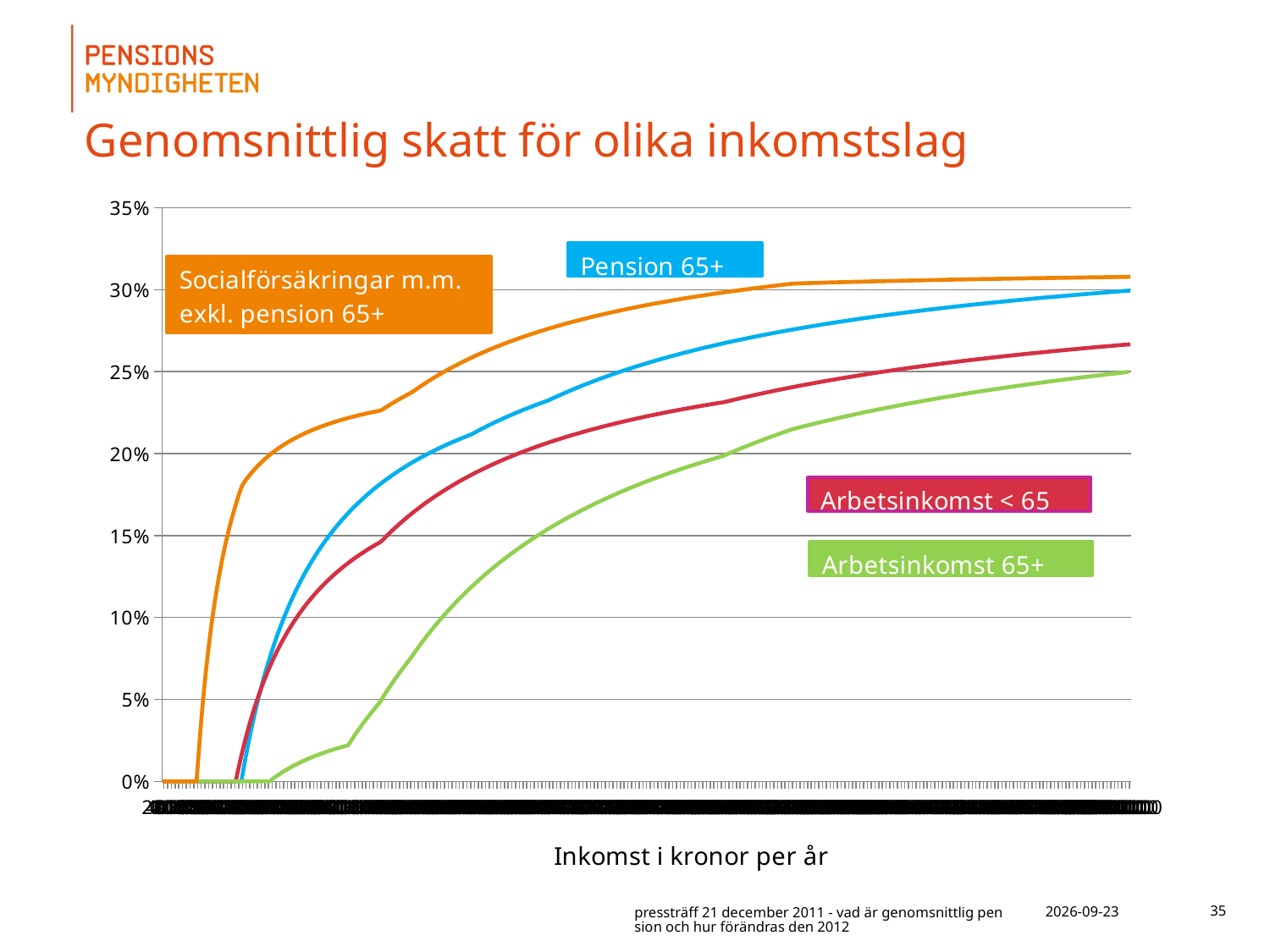
Is the highest value reached by the Arbetsinkomst 65+ line greater or less than 30%? less Do the values of the lines rise or fall as income increases along the x axis? Rise At the right end of the chart, which is larger: Pension 65+ or Arbetsinkomst < 65? Pension 65+ Is the highest value reached by the Socialförsäkringar m.m. exkl. pension 65+ line greater or less than 30%? greater Which series has the highest values across the chart? Socialförsäkringar m.m. exkl. pension 65+ What is the title of the chart? Genomsnittlig skatt för olika inkomstslag How many data series are labelled on the chart? 4 Is the value of the Arbetsinkomst < 65 line at the right end of the chart greater or less than 25%? greater Which series has the lowest values across the chart? Arbetsinkomst 65+ What is the label of the x axis? Inkomst i kronor per år Which series starts rising from 0% at the lowest income level? Socialförsäkringar m.m. exkl. pension 65+ What kind of chart is shown on the slide? Line chart